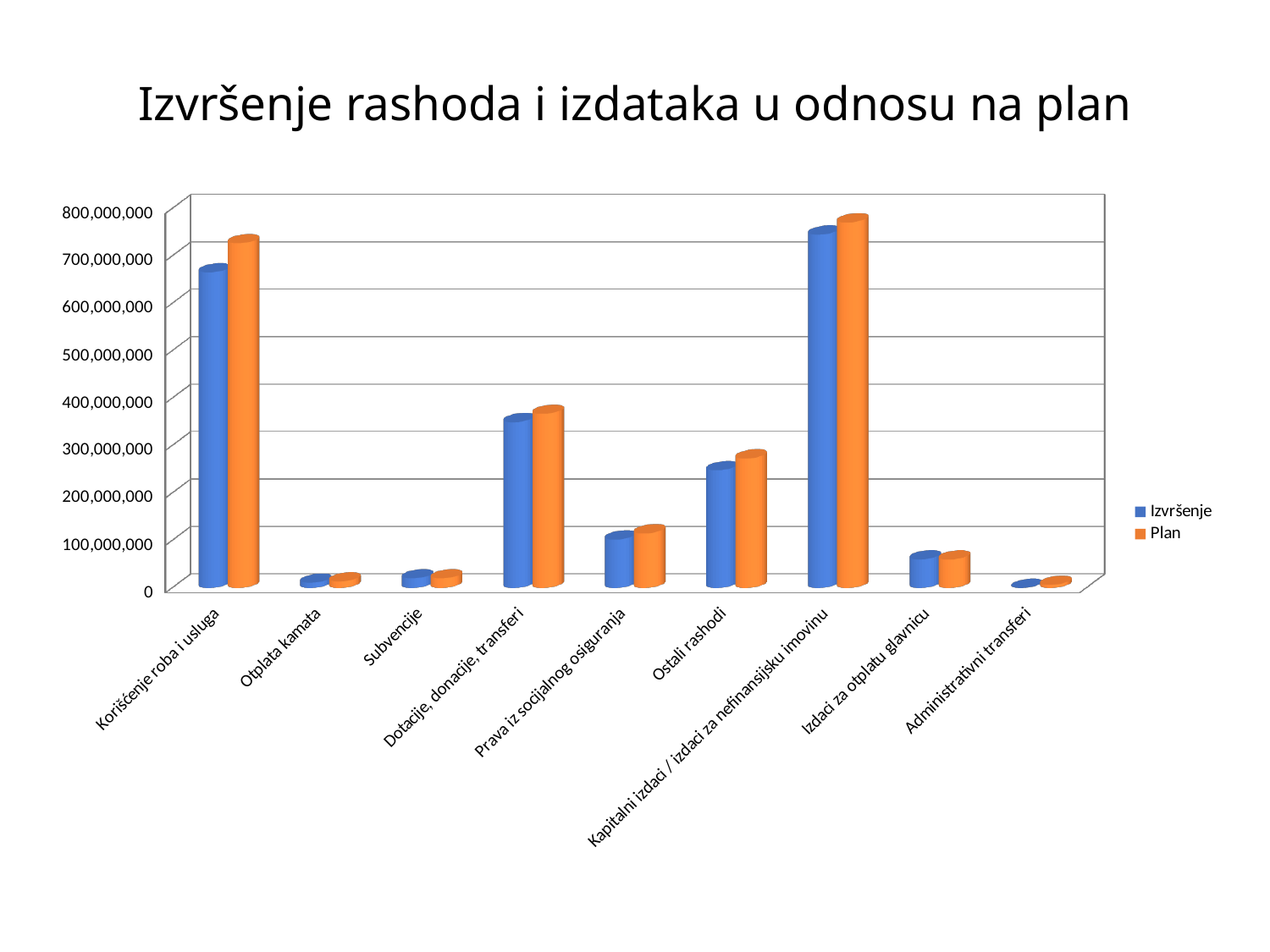
Which series is shown in orange? Plan Which category has the lowest Izvršenje value? Administrativni transferi What is the title of the chart? Izvršenje rashoda i izdataka u odnosu na plan For Korišćenje roba i usluga, which is larger: Izvršenje or Plan? Plan Is the Izvršenje value for Prava iz socijalnog osiguranja greater or less than 200,000,000? less Is the Izvršenje value for Korišćenje roba i usluga greater or less than 600,000,000? greater What kind of chart is shown on the slide? bar chart How many series does the legend list? 2 Is the Plan value for Izdaci za otplatu glavnicu greater or less than 100,000,000? less Which category has the highest Plan value? Kapitalni izdaci / izdaci za nefinansijsku imovinu How many categories are shown on the x axis? 9